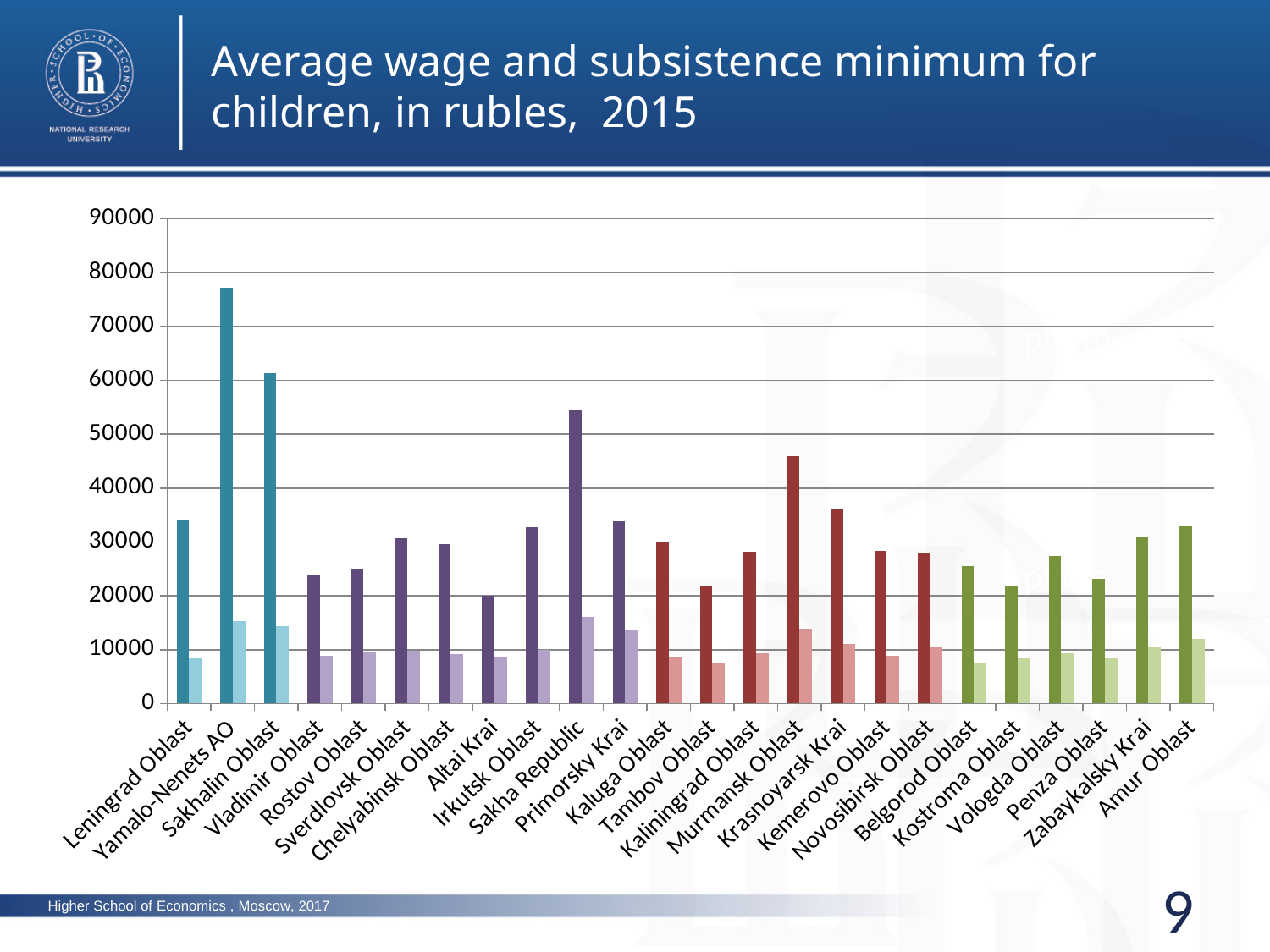
Is the shorter (lighter) bar for Tambov Oblast greater or less than 10000? less Is the taller bar for Sakha Republic greater or less than 50000? greater Is the taller bar for Sakhalin Oblast greater or less than 60000? greater What kind of chart is shown on the slide? bar chart Which region has the tallest bar in the chart? Yamalo-Nenets AO What is the title of the chart on the slide? Average wage and subsistence minimum for children, in rubles, 2015 How many regions are listed along the x axis of the chart? 24 Which region has the taller dark bar, Murmansk Oblast or Krasnoyarsk Krai? Murmansk Oblast Which region has the taller dark bar, Vladimir Oblast or Sverdlovsk Oblast? Sverdlovsk Oblast Among the taller (darker) bars, which region has the lowest value? Altai Krai